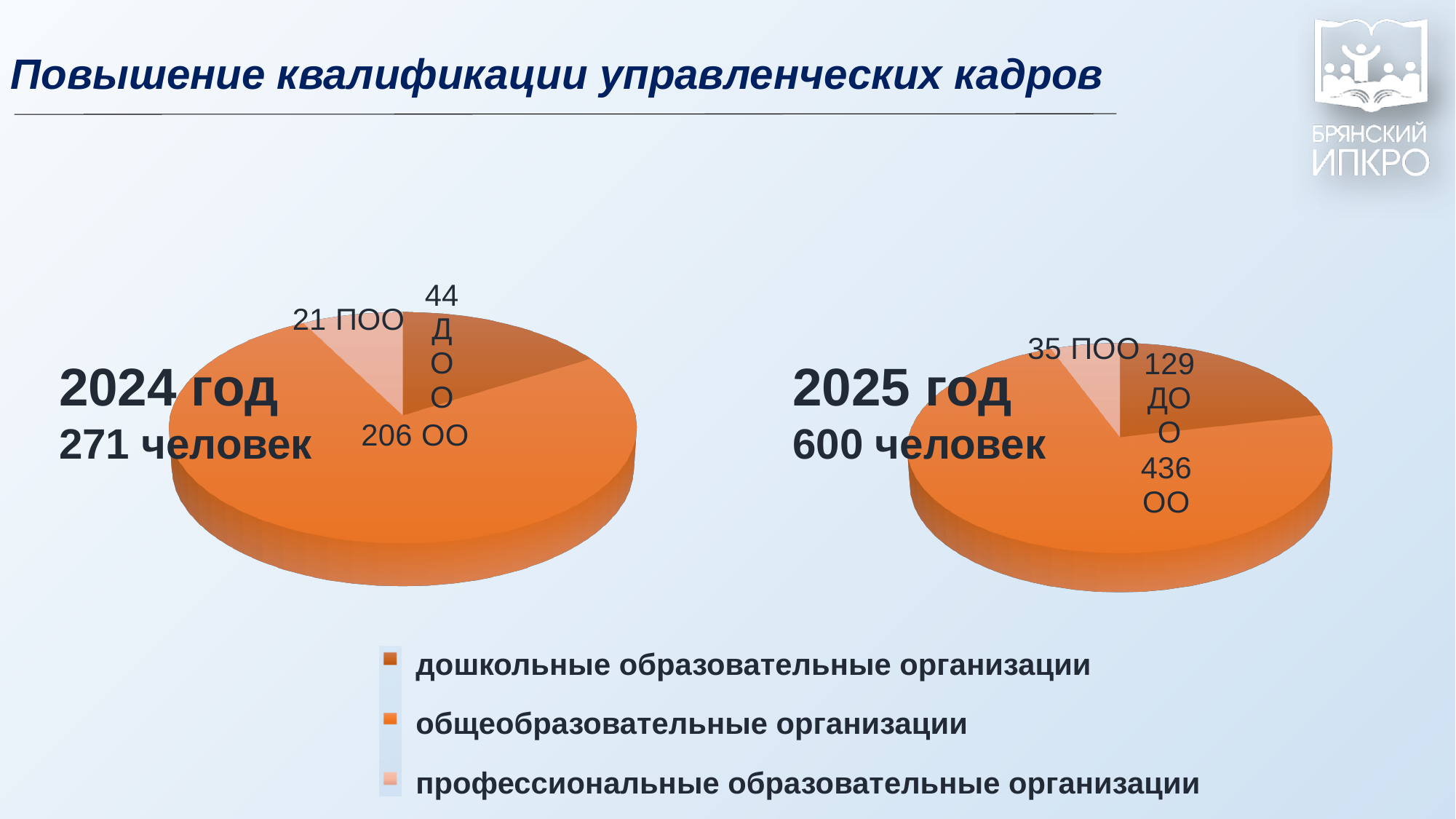
In the 2024 pie chart, what is the value for ДОО (дошкольные образовательные организации)? 44 In the 2025 pie chart, which category has the largest slice? ОО (общеобразовательные организации) In the 2025 pie chart, what is the value for ОО (общеобразовательные организации)? 436 In the 2025 pie chart, what is the value for ПОО (профессиональные образовательные организации)? 35 What is the total number of people shown for the 2025 pie chart? 600 человек In the 2024 pie chart, what is the value for ОО (общеобразовательные организации)? 206 In the 2024 pie chart, which category has the smallest slice? ПОО (профессиональные образовательные организации) What type of chart is used on this slide? Pie chart How many entries does the legend list? 3 What is the difference between the ДОО values in the 2025 and 2024 pie charts? 85 Which is larger: the ПОО value in the 2024 pie chart or the ПОО value in the 2025 pie chart? 2025 (35) How many categories does each pie chart contain? 3